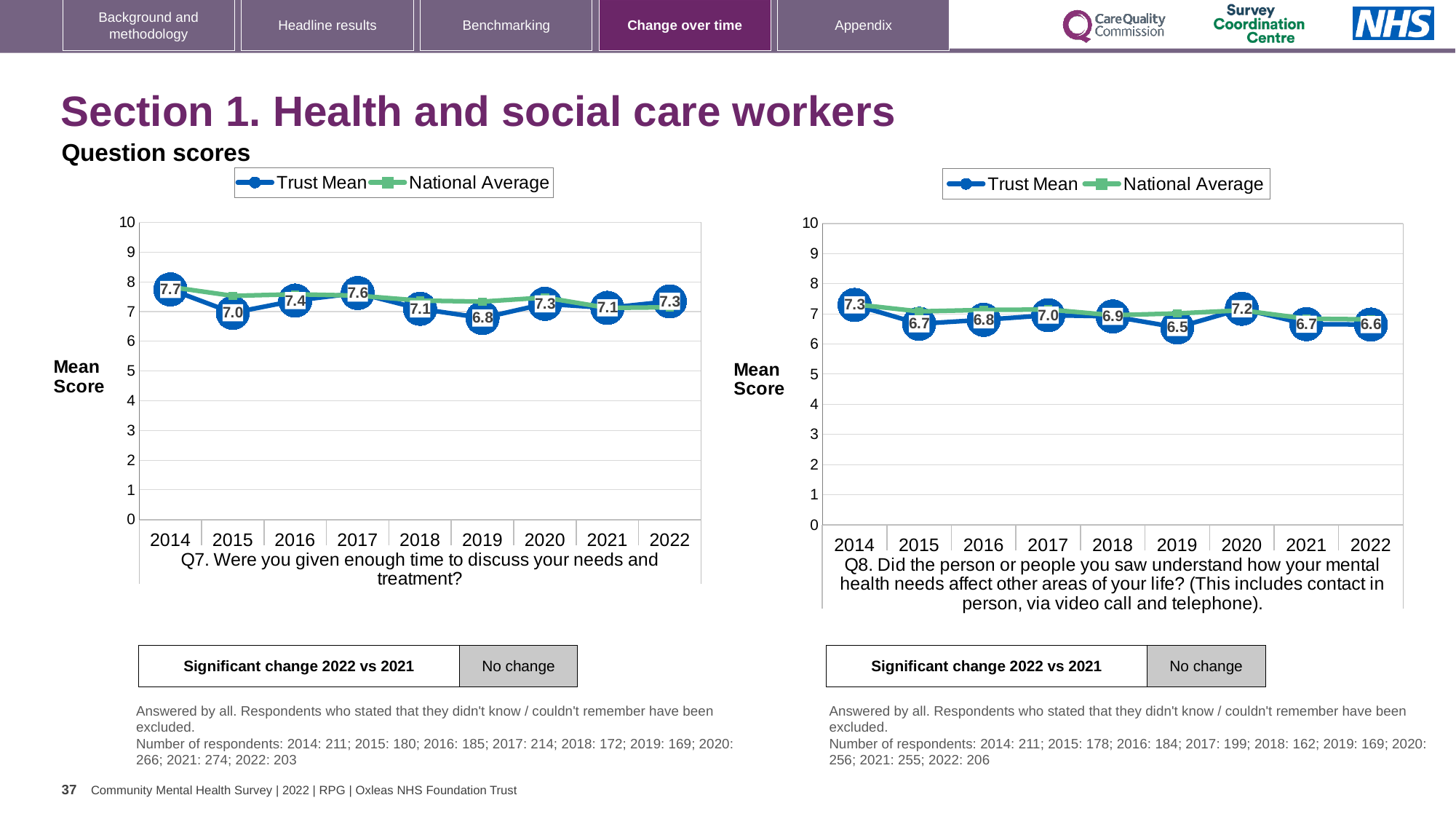
In the right chart (Q8), which year has the lowest Trust Mean score? 2019 How many years are plotted on the x axis of the left chart (Q7)? 9 How many series does the legend of the right chart (Q8) list? 2 In the left chart (Q7), which year has the lowest Trust Mean score? 2019 In the left chart (Q7), what is the Trust Mean score for 2019? 6.8 In the right chart (Q8), is the Trust Mean score for 2020 or 2021 larger? 2020 In the left chart (Q7), what is the Trust Mean score for 2014? 7.7 In the right chart (Q8), which year has the highest Trust Mean score? 2014 In the right chart (Q8), what is the Trust Mean score for 2022? 6.6 In the left chart (Q7), what is the difference between the Trust Mean scores for 2017 and 2015? 0.6 What type of chart is the left chart (Q7)? Line chart In the left chart (Q7), which year has the highest Trust Mean score? 2014